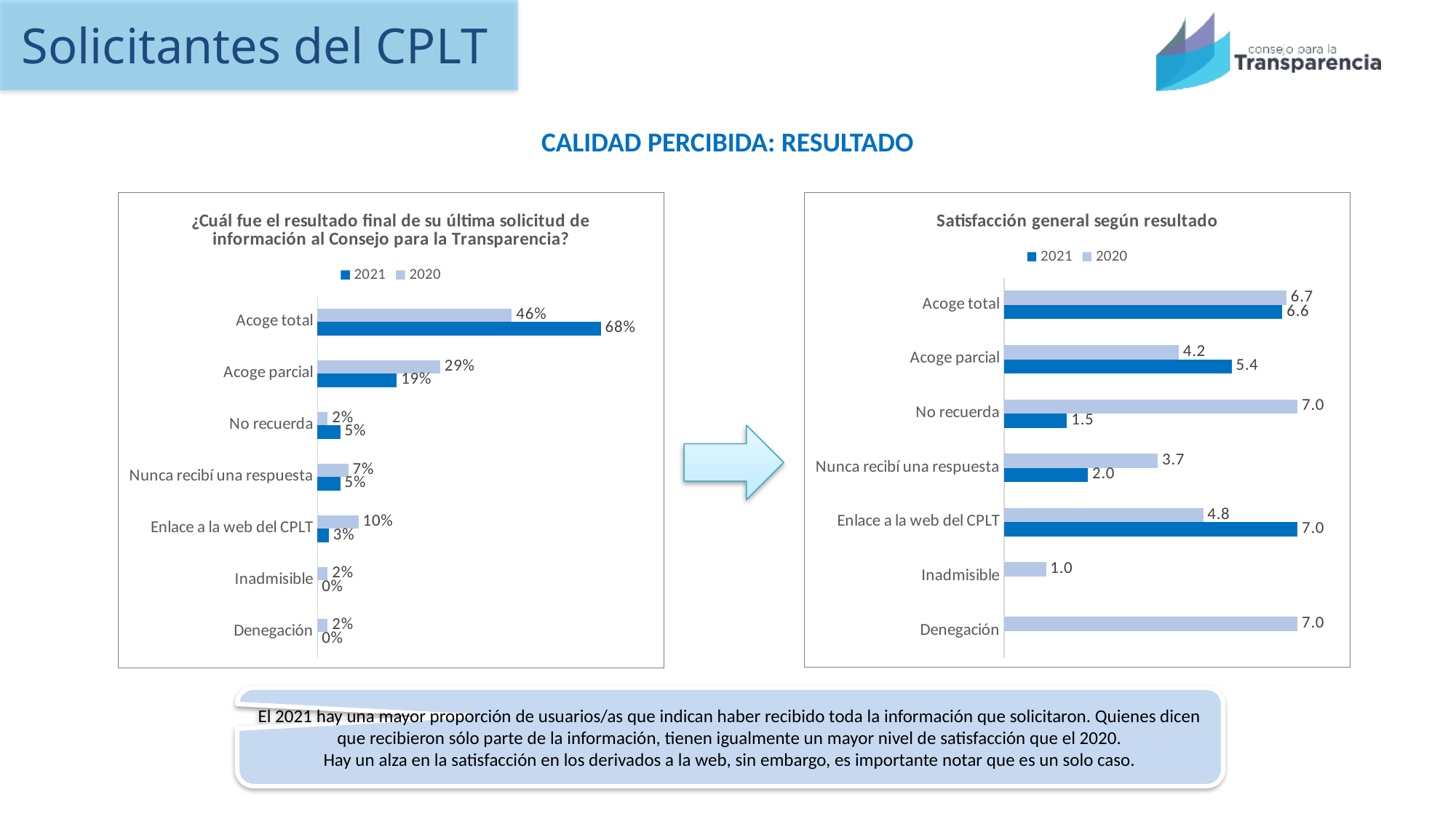
In the right chart (Satisfacción general según resultado), what is the difference between the 2020 and 2021 values for No recuerda? 5.5 In the left chart (¿Cuál fue el resultado final de su última solicitud...?), what is the 2021 value for Acoge total? 68% In the left chart (¿Cuál fue el resultado final de su última solicitud...?), what is the 2020 value for Acoge parcial? 29% What type of chart is the right chart (Satisfacción general según resultado)? Bar chart In the left chart (¿Cuál fue el resultado final de su última solicitud...?), which is larger for Enlace a la web del CPLT, the 2020 value or the 2021 value? 2020 In the left chart (¿Cuál fue el resultado final de su última solicitud...?), how many categories are shown? 7 In the left chart (¿Cuál fue el resultado final de su última solicitud...?), what is the difference between the 2021 and 2020 values for Acoge total? 22% In the right chart (Satisfacción general según resultado), what is the 2021 value for Acoge parcial? 5.4 In the right chart (Satisfacción general según resultado), which category has the lowest 2021 value? No recuerda In the left chart (¿Cuál fue el resultado final de su última solicitud...?), which category has the highest 2021 value? Acoge total In the right chart (Satisfacción general según resultado), what is the 2020 value for Nunca recibí una respuesta? 3.7 In the right chart (Satisfacción general según resultado), how many series does the legend list? 2